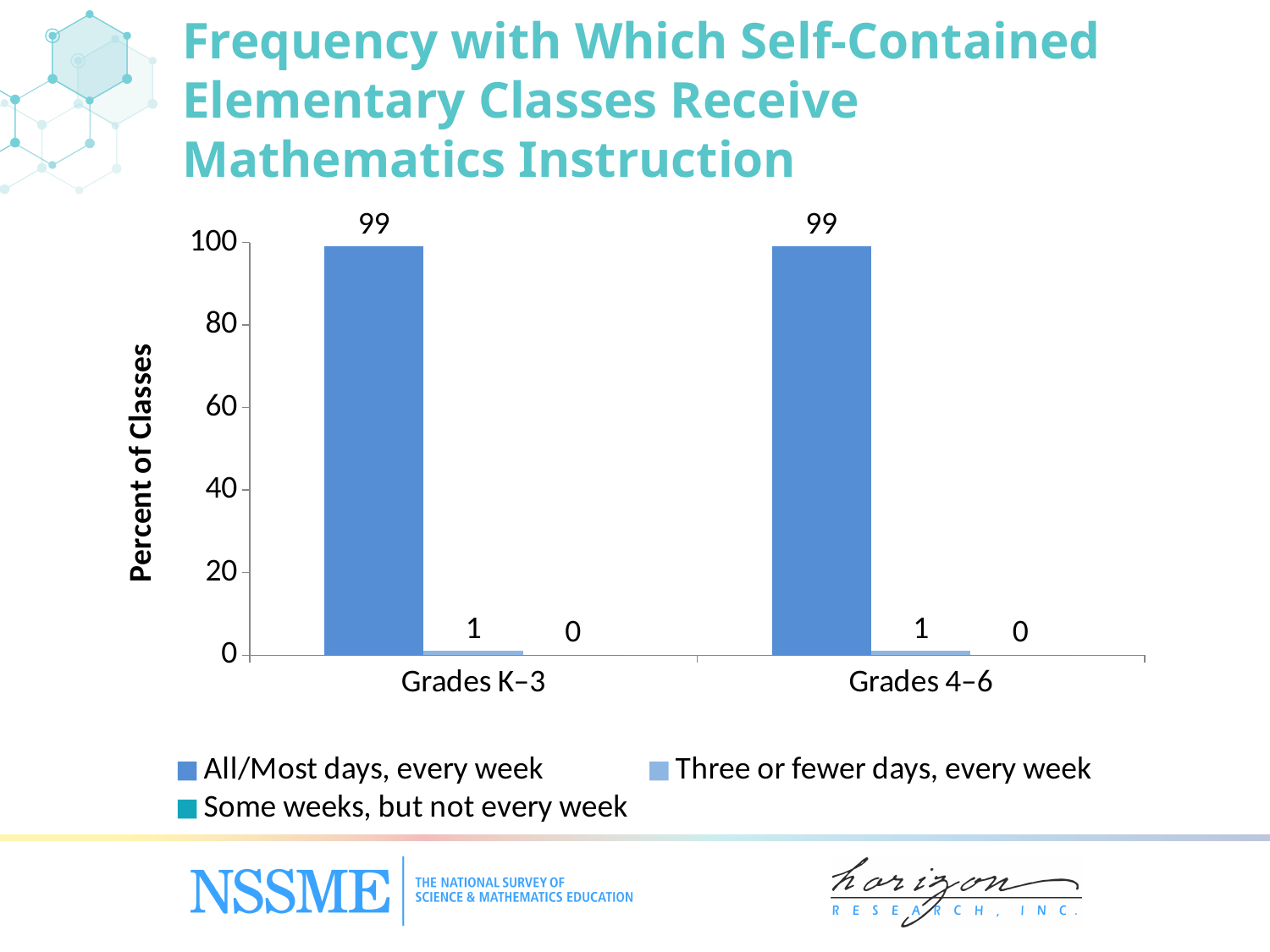
What percent of Grades 4–6 classes receive mathematics instruction three or fewer days, every week? 1 Is the 'All/Most days, every week' value for Grades 4–6 greater or less than 80? greater What percent of Grades K–3 classes receive mathematics instruction all/most days, every week? 99 Which frequency category has the highest value for Grades K–3? All/Most days, every week How many series does the legend list? 3 What is the label of the y axis? Percent of Classes How many grade-band categories are shown on the x axis? 2 What is the difference between the 'All/Most days, every week' value and the 'Three or fewer days, every week' value for Grades K–3? 98 Which frequency category has the lowest value for Grades 4–6? Some weeks, but not every week What percent of Grades 4–6 classes receive mathematics instruction all/most days, every week? 99 What percent of Grades K–3 classes receive mathematics instruction some weeks, but not every week? 0 What kind of chart is shown on the slide? Bar chart